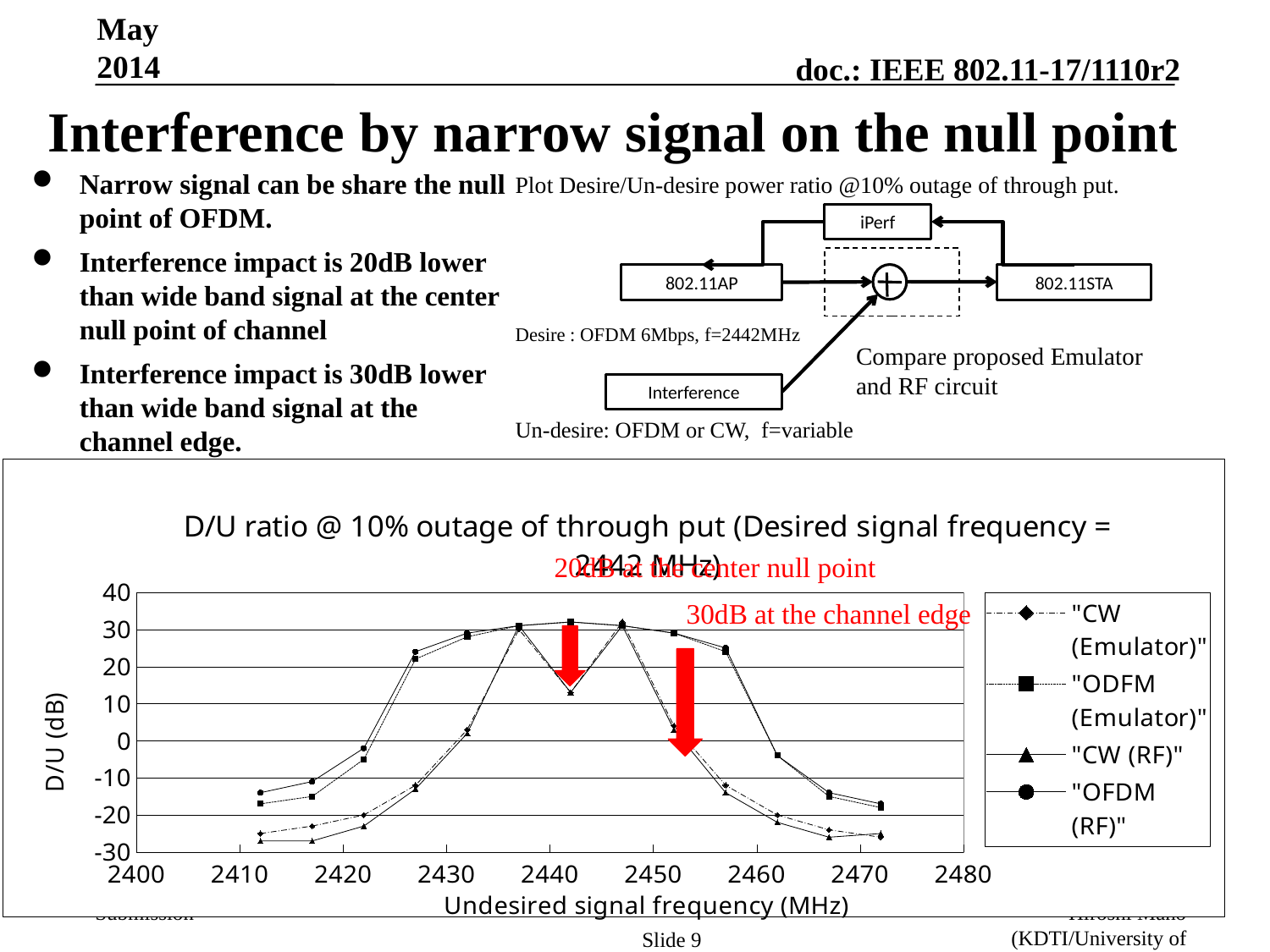
Is the value of the "CW (RF)" series at 2412 MHz greater or less than -20? less Is the value of the "CW (RF)" series at 2462 MHz greater or less than -10? less At 2452 MHz, which series has the larger D/U value, "ODFM (Emulator)" or "CW (Emulator)"? ODFM (Emulator) How many series does the chart legend list? 4 Is the value of the "OFDM (RF)" series at 2442 MHz greater or less than 20? greater At 2442 MHz, which series has the larger D/U value, "OFDM (RF)" or "CW (RF)"? OFDM (RF) What is the label of the horizontal axis of the chart? Undesired signal frequency (MHz) What is the label of the vertical axis of the chart? D/U (dB) Do the values of the "OFDM (RF)" series rise or fall as the undesired signal frequency increases from 2447 MHz to 2472 MHz? fall What kind of chart is shown on the slide? line chart